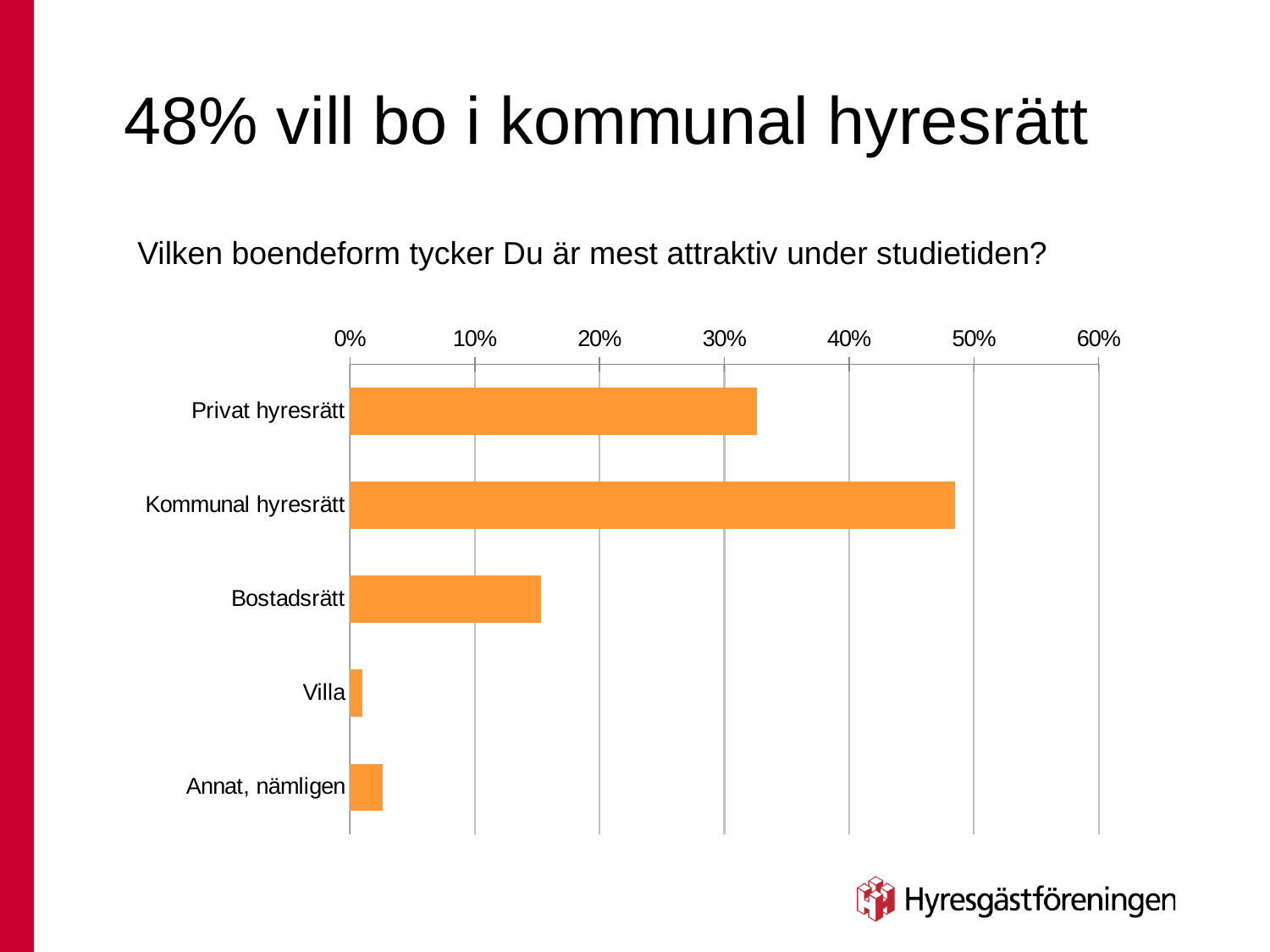
Which category has the lowest value in the chart? Villa What kind of chart is shown on the slide? bar chart What is the title of the slide above the chart? 48% vill bo i kommunal hyresrätt Is the value for Kommunal hyresrätt greater or less than 40%? greater Which is larger, the value for Privat hyresrätt or the value for Bostadsrätt? Privat hyresrätt Which category has the highest value in the chart? Kommunal hyresrätt Is the value for Bostadsrätt greater or less than 10%? greater How many housing categories are plotted in the chart? 5 Is the value for Annat, nämligen greater or less than 10%? less